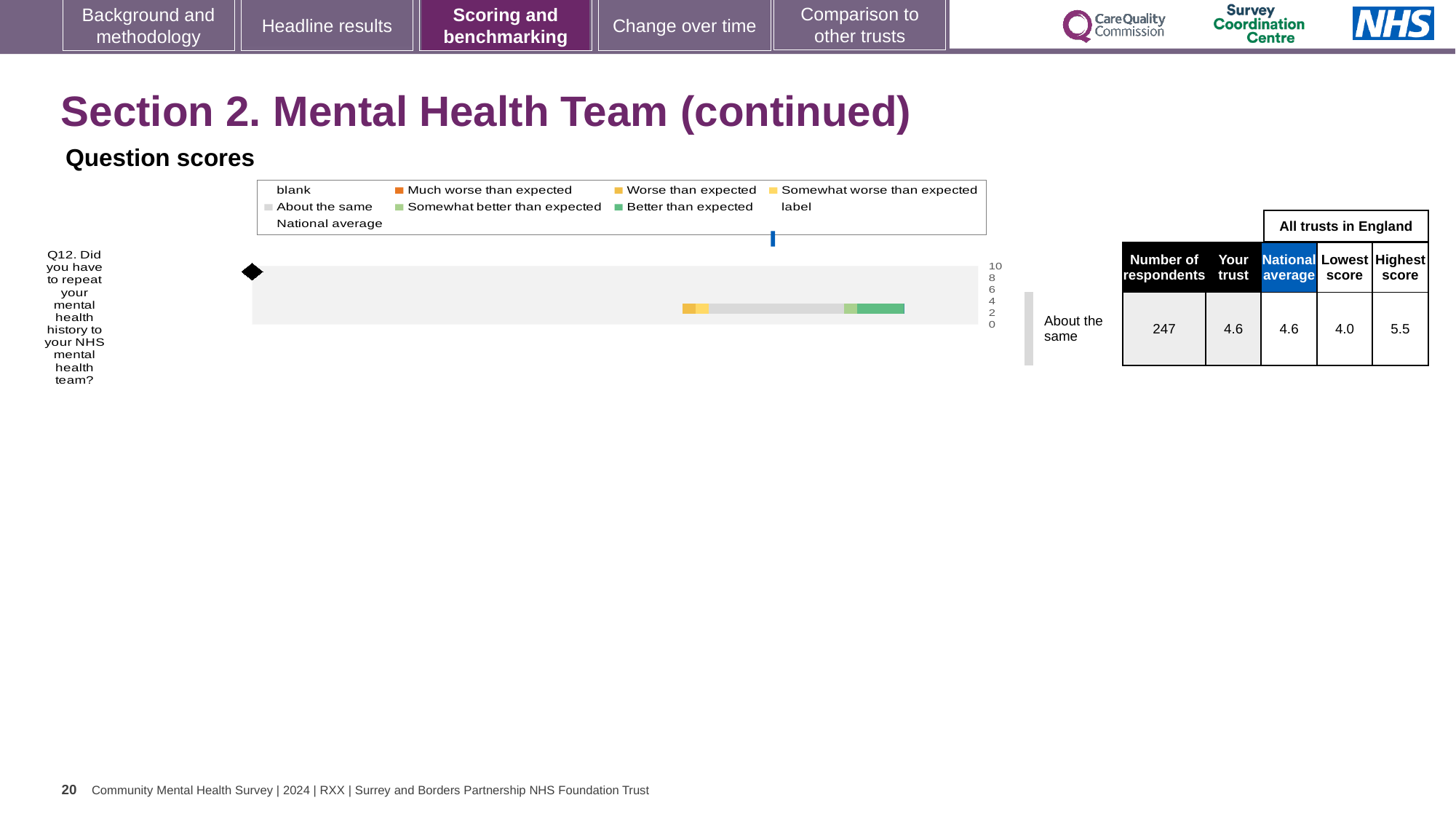
What is the difference between the 'Your trust' score and the lowest score for Q12? 0.6 How many survey questions are plotted in the chart? 1 What is the lowest score among all trusts in England for Q12? 4.0 What is the 'Your trust' score for Q12? 4.6 What is the difference between the highest score and the lowest score for Q12? 1.5 What is the national average score for Q12? 4.6 Which survey question is plotted in the chart? Q12. Did you have to repeat your mental health history to your NHS mental health team? What is the highest score among all trusts in England for Q12? 5.5 How many respondents answered Q12? 247 What kind of chart is shown on the slide? bar chart Is the highest score for Q12 greater or less than 5? greater How is the trust's result for Q12 categorised next to the chart? About the same